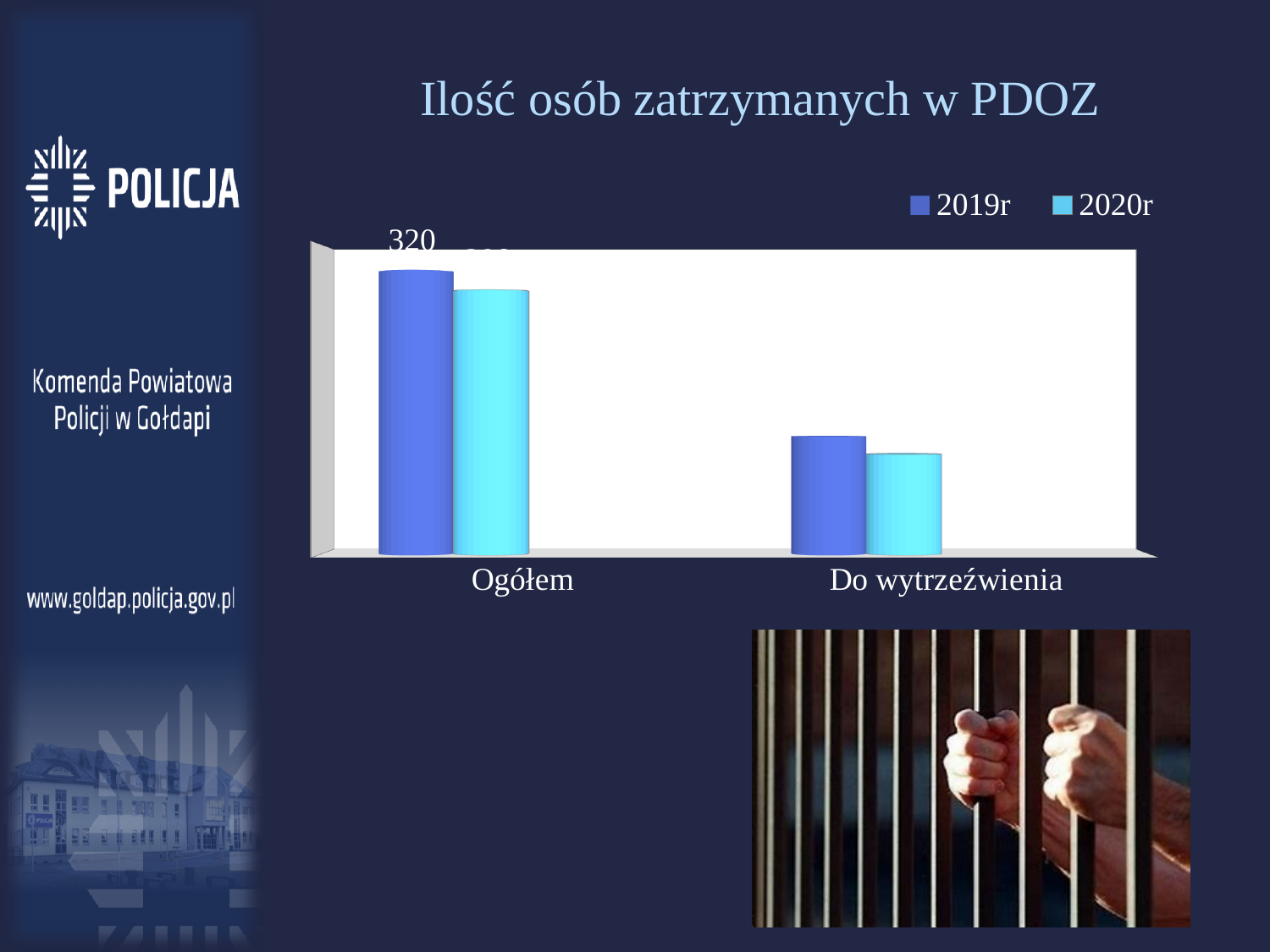
In the Do wytrzeźwienia category, which series has the larger value, 2019r or 2020r? 2019r In the Ogółem category, which series has the larger value, 2019r or 2020r? 2019r Which series are listed in the legend? 2019r and 2020r How many categories are shown on the x axis? 2 What is the value for 2019r in the Ogółem category? 320 Which category has the lowest value for 2020r? Do wytrzeźwienia Which category has the highest value for 2019r? Ogółem For 2020r, which category has the larger value, Ogółem or Do wytrzeźwienia? Ogółem How many series does the legend list? 2 What is the title of the chart? Ilość osób zatrzymanych w PDOZ What kind of chart is shown on the slide? Bar chart